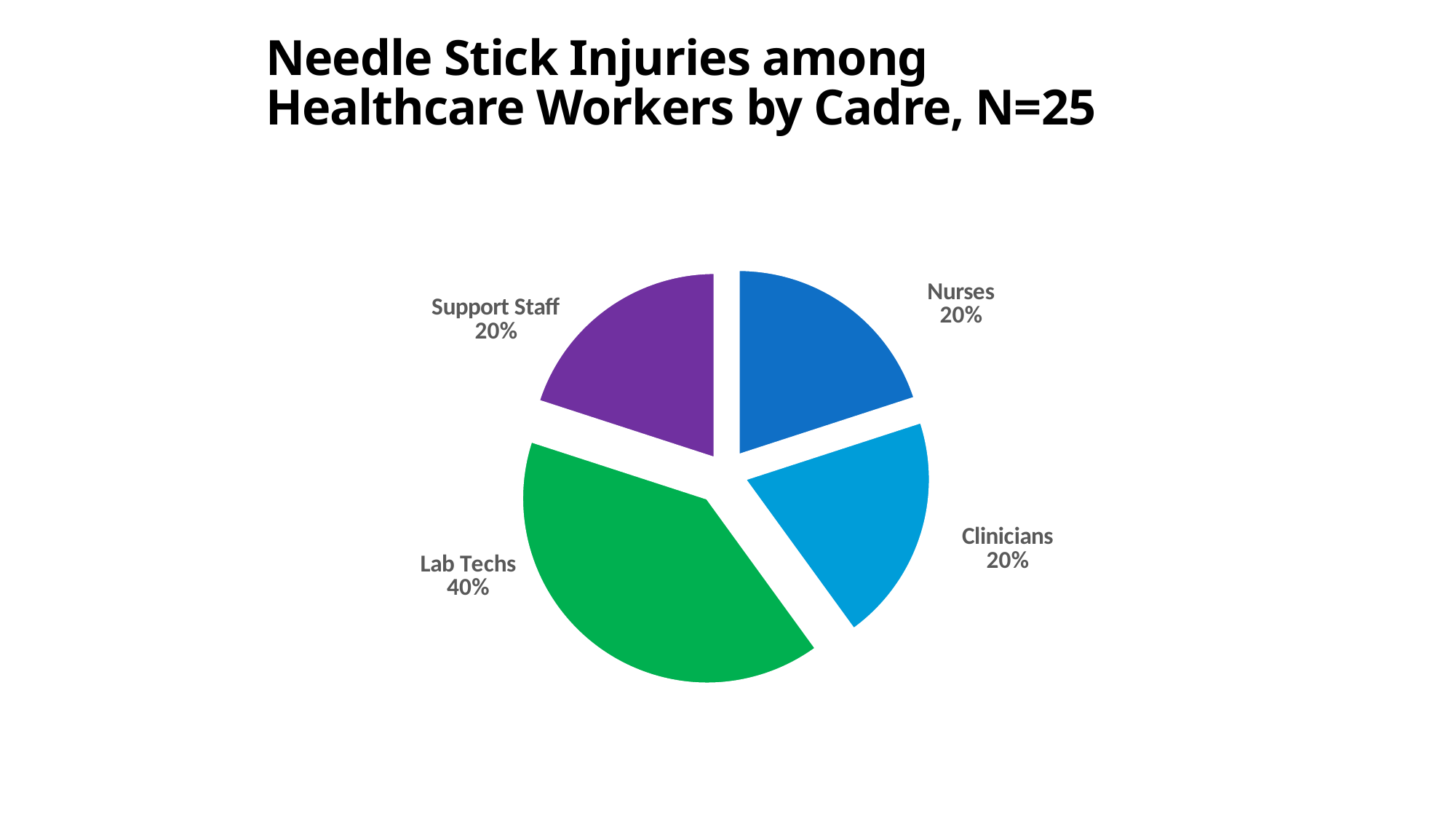
What is the combined share of Nurses and Clinicians? 40% What colour is the Lab Techs slice? Green What share of needle stick injuries is attributed to Support Staff? 20% What share of needle stick injuries is attributed to Lab Techs? 40% What share of needle stick injuries is attributed to Clinicians? 20% How many cadres (slices) are shown in the pie chart? 4 What is the title of the chart? Needle Stick Injuries among Healthcare Workers by Cadre, N=25 What kind of chart is shown on the slide? Pie chart What is the difference in percentage points between the Lab Techs share and the Nurses share? 20% Which is larger, the share for Lab Techs or the share for Clinicians? Lab Techs Which cadre has the largest share of needle stick injuries? Lab Techs